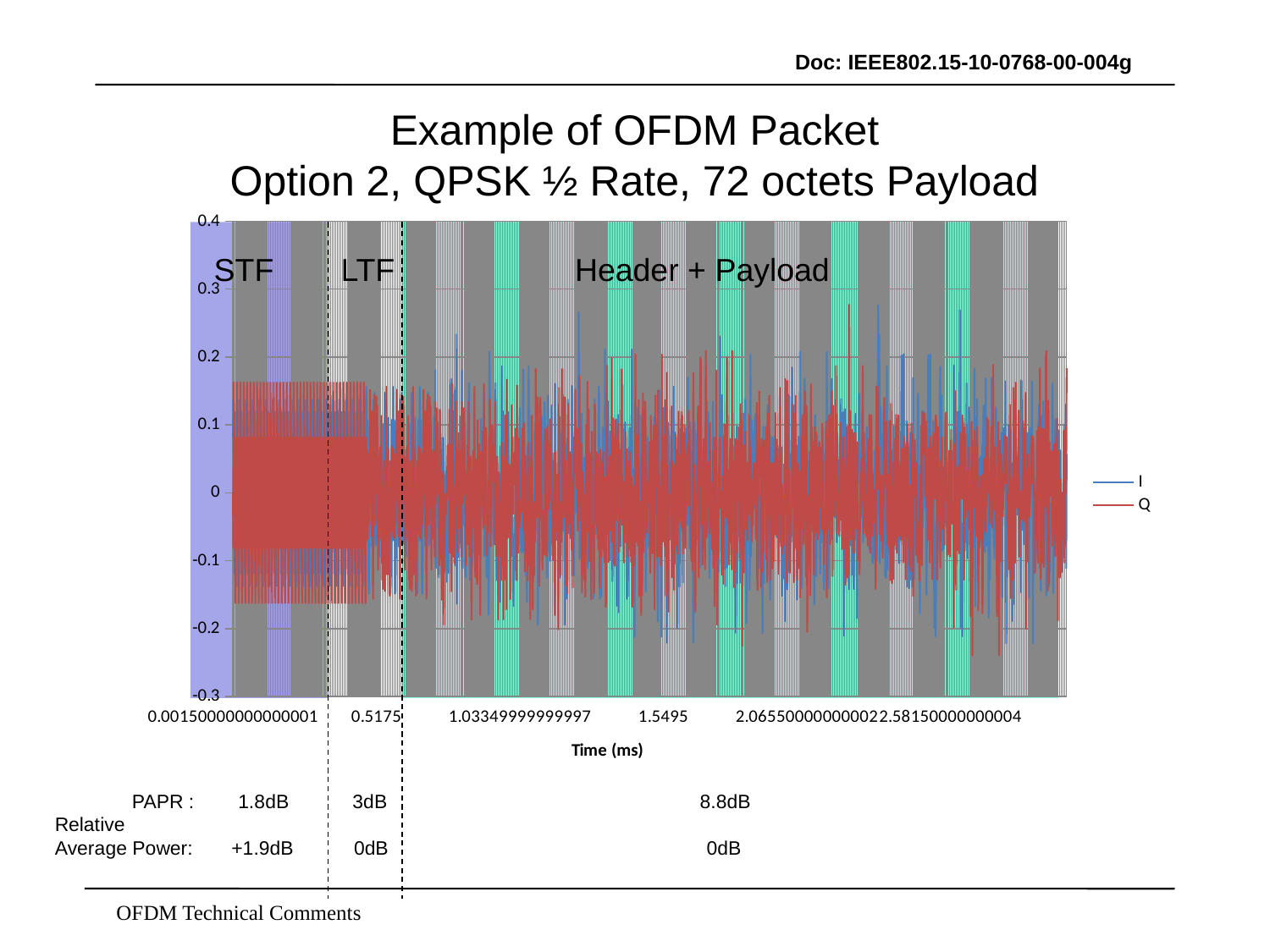
What are the two series named in the chart legend? I and Q What kind of chart is shown on the slide? line chart How many series does the chart legend list? 2 In the STF region at the start of the chart, is the peak amplitude of the Q series greater or less than 0.1? greater In the STF region, is the lowest value of the I series greater or less than -0.2? greater In the Header + Payload region, is the highest peak of the I series greater or less than 0.2? greater What is the title of the chart's x axis? Time (ms)